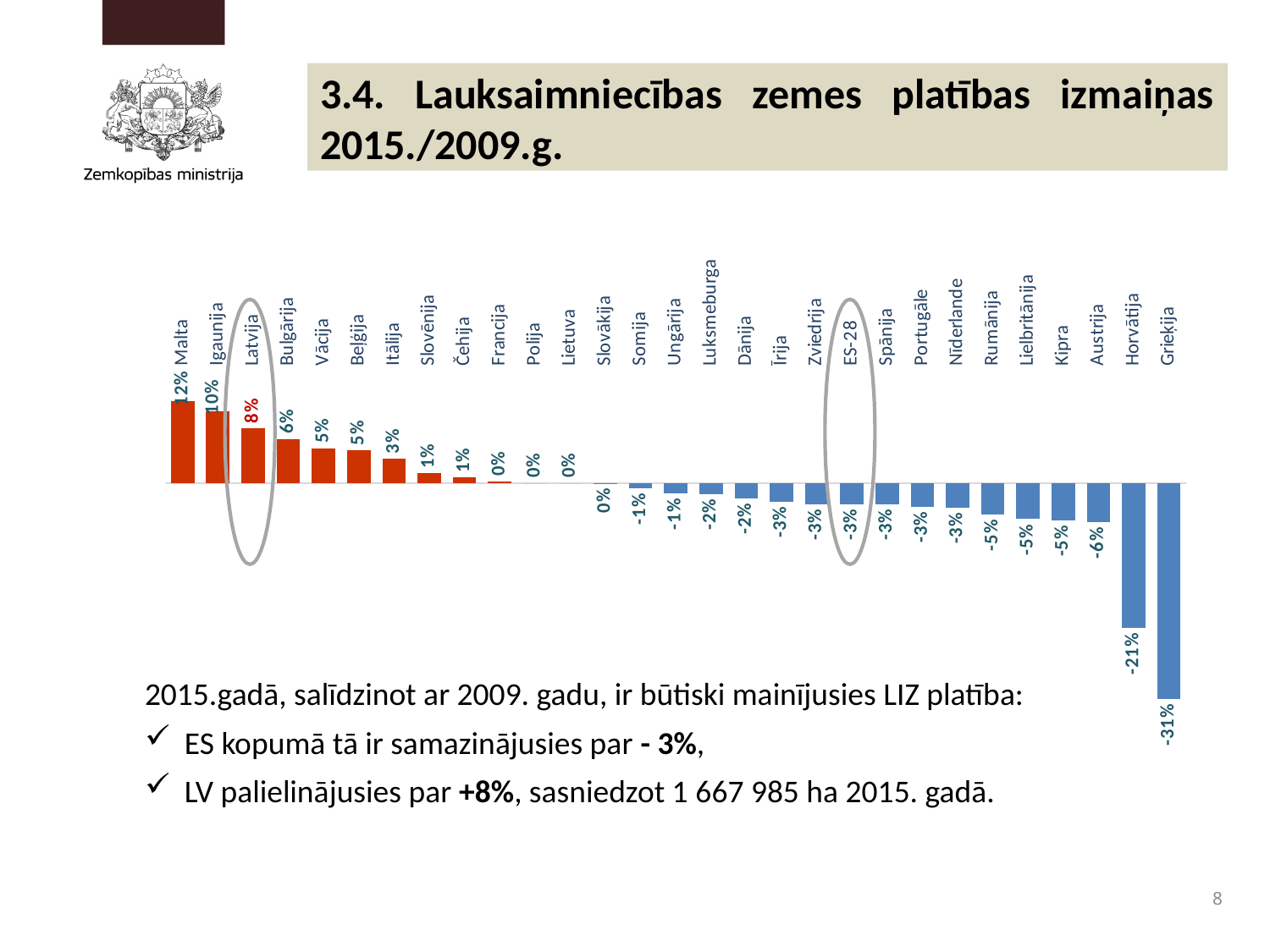
Which country has the lowest value in the chart? Grieķija Which country has the highest value in the chart? Malta Do the values rise or fall moving from left to right along the x axis? Fall What is the value shown for ES-28? -3% Which has the larger value, Bulgārija or Itālija? Bulgārija What kind of chart is shown on the slide? Bar chart What is the difference between the values for Malta and Igaunija? 2 percentage points What is the value shown for Malta? 12% What is the value shown for Latvija? 8% Which two categories are circled on the chart? Latvija and ES-28 What is the value shown for Horvātija? -21% What is the value shown for Grieķija? -31%